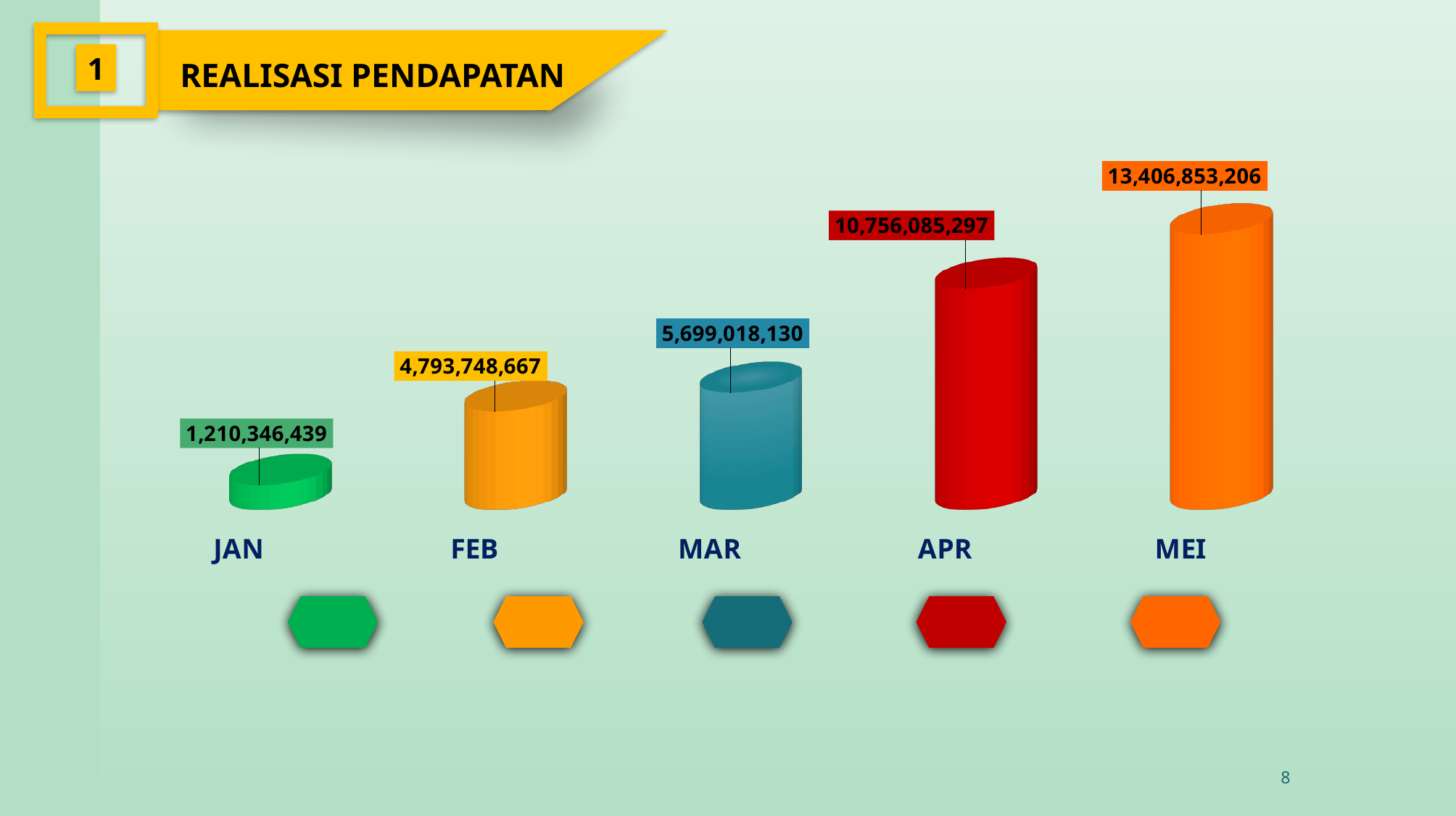
What is the value shown for JAN? 1,210,346,439 How many months are shown in the chart? 5 What is the difference between the values for MEI and APR? 2,650,767,909 Do the values rise or fall from JAN to MEI? Rise What is the title of the slide containing the chart? REALISASI PENDAPATAN What is the difference between the values for MAR and FEB? 905,269,463 What kind of chart is shown on the slide? Bar chart Which is larger, the value for FEB or the value for MAR? MAR What is the value shown for APR? 10,756,085,297 What is the value shown for MAR? 5,699,018,130 Which month has the highest value? MEI Which month has the lowest value? JAN